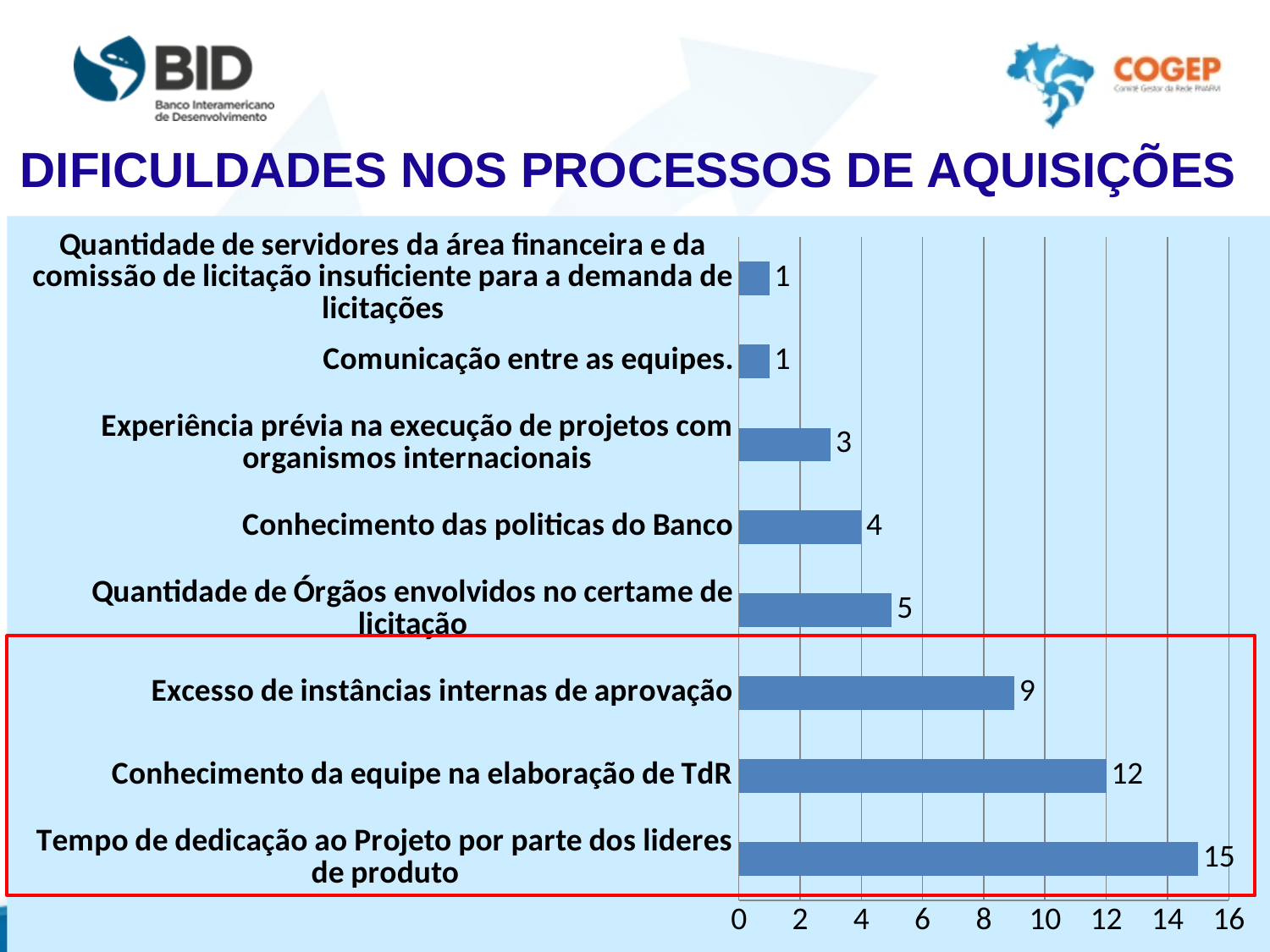
What is the value for "Experiência prévia na execução de projetos com organismos internacionais"? 3 What is the difference between the values for "Tempo de dedicação ao Projeto por parte dos lideres de produto" and "Conhecimento da equipe na elaboração de TdR"? 3 What is the value for "Excesso de instâncias internas de aprovação"? 9 Which is larger: the value for "Excesso de instâncias internas de aprovação" or the value for "Quantidade de Órgãos envolvidos no certame de licitação"? Excesso de instâncias internas de aprovação What is the value for "Tempo de dedicação ao Projeto por parte dos lideres de produto"? 15 What is the value for "Conhecimento das politicas do Banco"? 4 What kind of chart is shown on the slide? Bar chart What is the title of the slide containing the chart? DIFICULDADES NOS PROCESSOS DE AQUISIÇÕES How many categories are shown in the chart? 8 Which category has the highest value? Tempo de dedicação ao Projeto por parte dos lideres de produto Is the value for "Conhecimento da equipe na elaboração de TdR" greater or less than 10? greater What is the value for "Conhecimento da equipe na elaboração de TdR"? 12